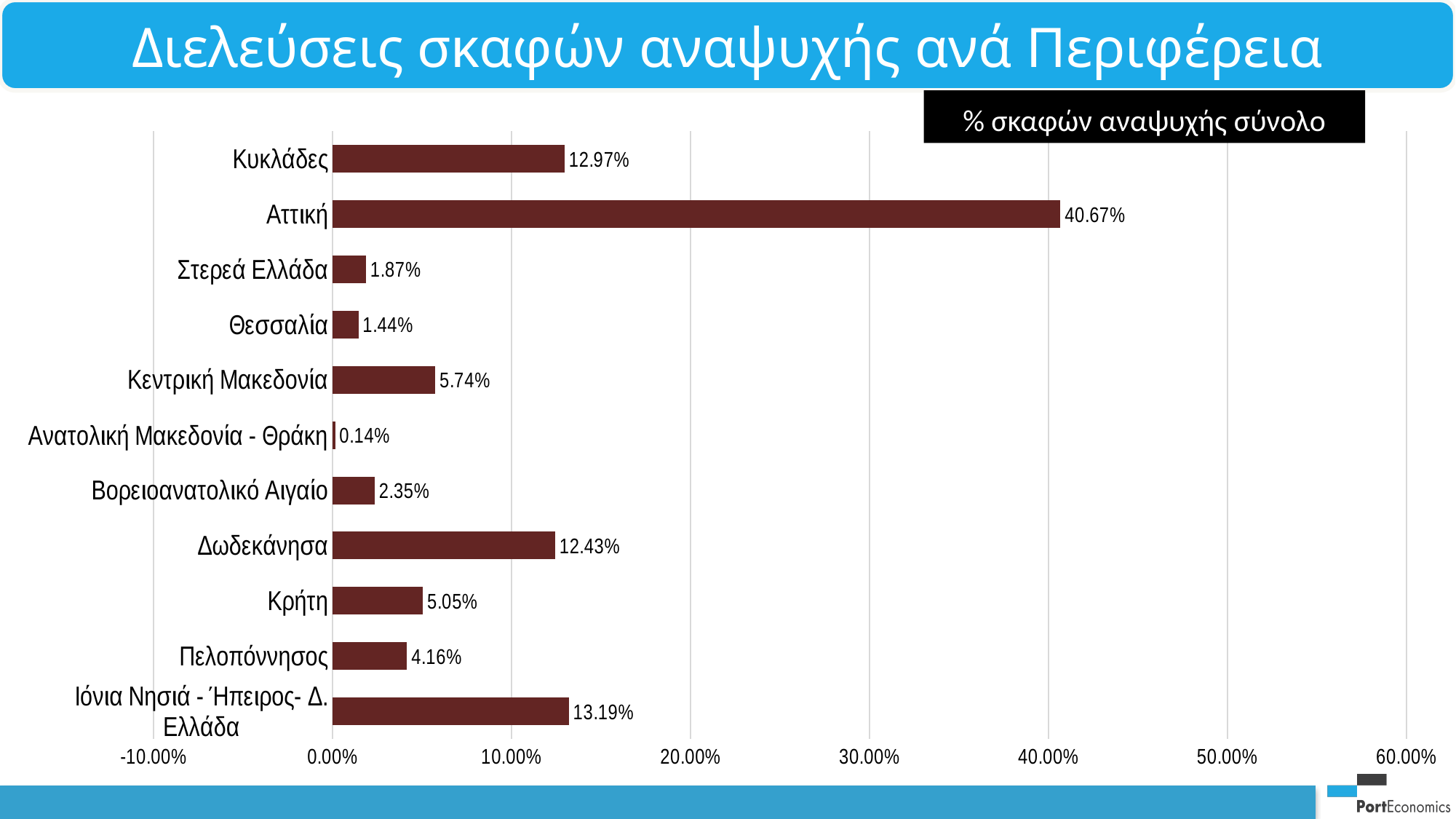
What kind of chart is shown on the slide? bar chart How many regions are shown in the chart? 11 What is the difference between the values for Αττική and Κυκλάδες? 27.70% Which is larger, the value for Κρήτη or the value for Πελοπόννησος? Κρήτη Which region has the highest value? Αττική What is the difference between the values for Ιόνια Νησιά - Ήπειρος- Δ. Ελλάδα and Δωδεκάνησα? 0.76% What is the title of the slide? Διελεύσεις σκαφών αναψυχής ανά Περιφέρεια What is the value for Δωδεκάνησα? 12.43% Which region has the lowest value? Ανατολική Μακεδονία - Θράκη What is the value for Ανατολική Μακεδονία - Θράκη? 0.14% Is the value for Αττική greater or less than 40.00%? greater What is the value for Αττική? 40.67%